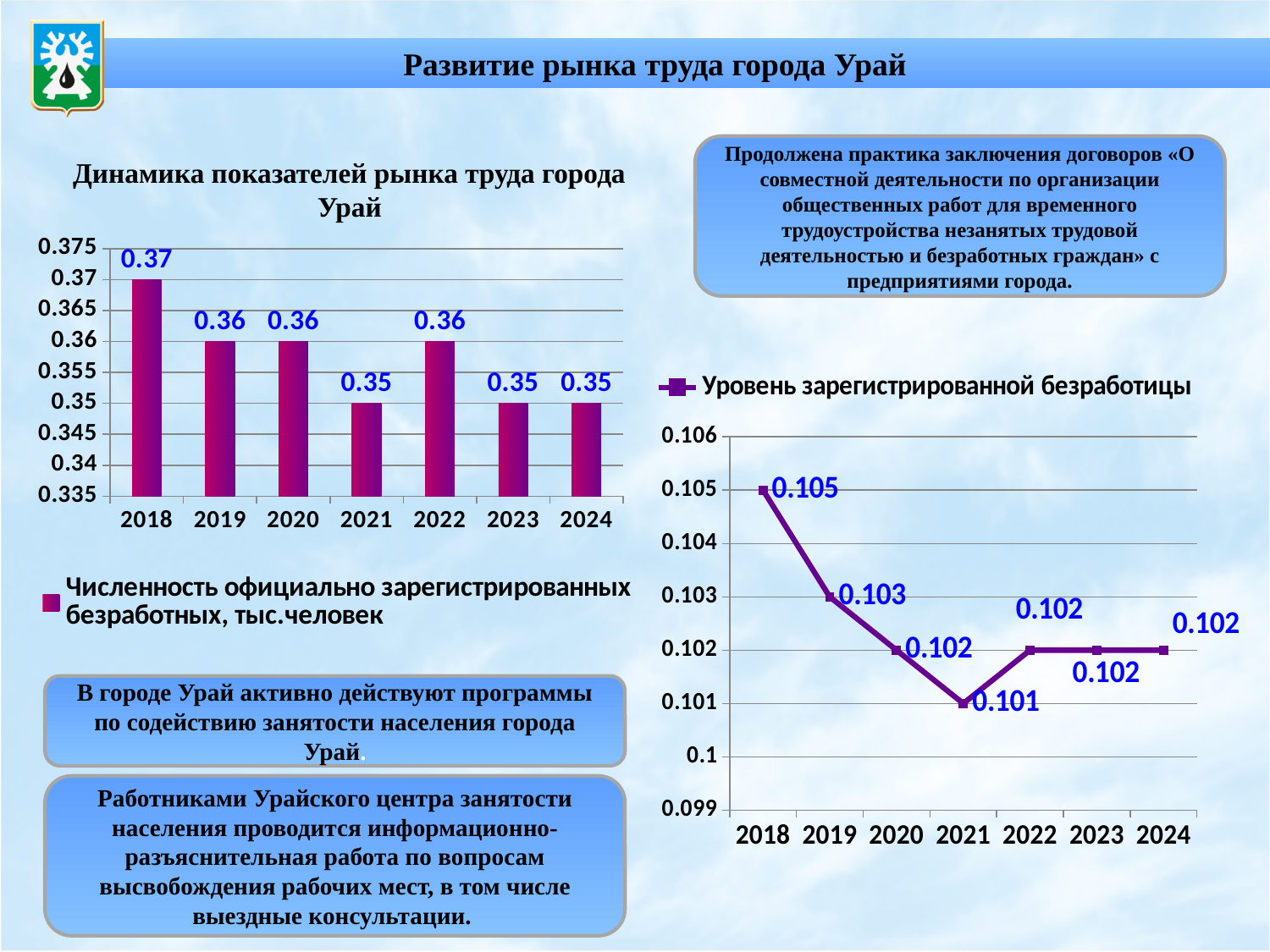
In the line chart on the right, what is the value for 2021? 0.101 What kind of chart is the chart on the left of the slide? Bar chart In the line chart on the right, what is the difference between the values for 2018 and 2024? 0.003 In the line chart on the right, what is the value for 2018? 0.105 In the bar chart on the left, what is the value for 2018? 0.37 In the line chart on the right, do the values rise or fall from 2018 to 2021? Fall In the bar chart on the left, what is the difference between the values for 2018 and 2022? 0.01 In the line chart on the right, is the value for 2019 larger or smaller than the value for 2020? Larger In the line chart on the right, which year has the lowest value? 2021 In the bar chart on the left, how many years are shown on the x axis? 7 In the bar chart on the left, which year has the highest value? 2018 In the bar chart on the left, what is the value for 2021? 0.35